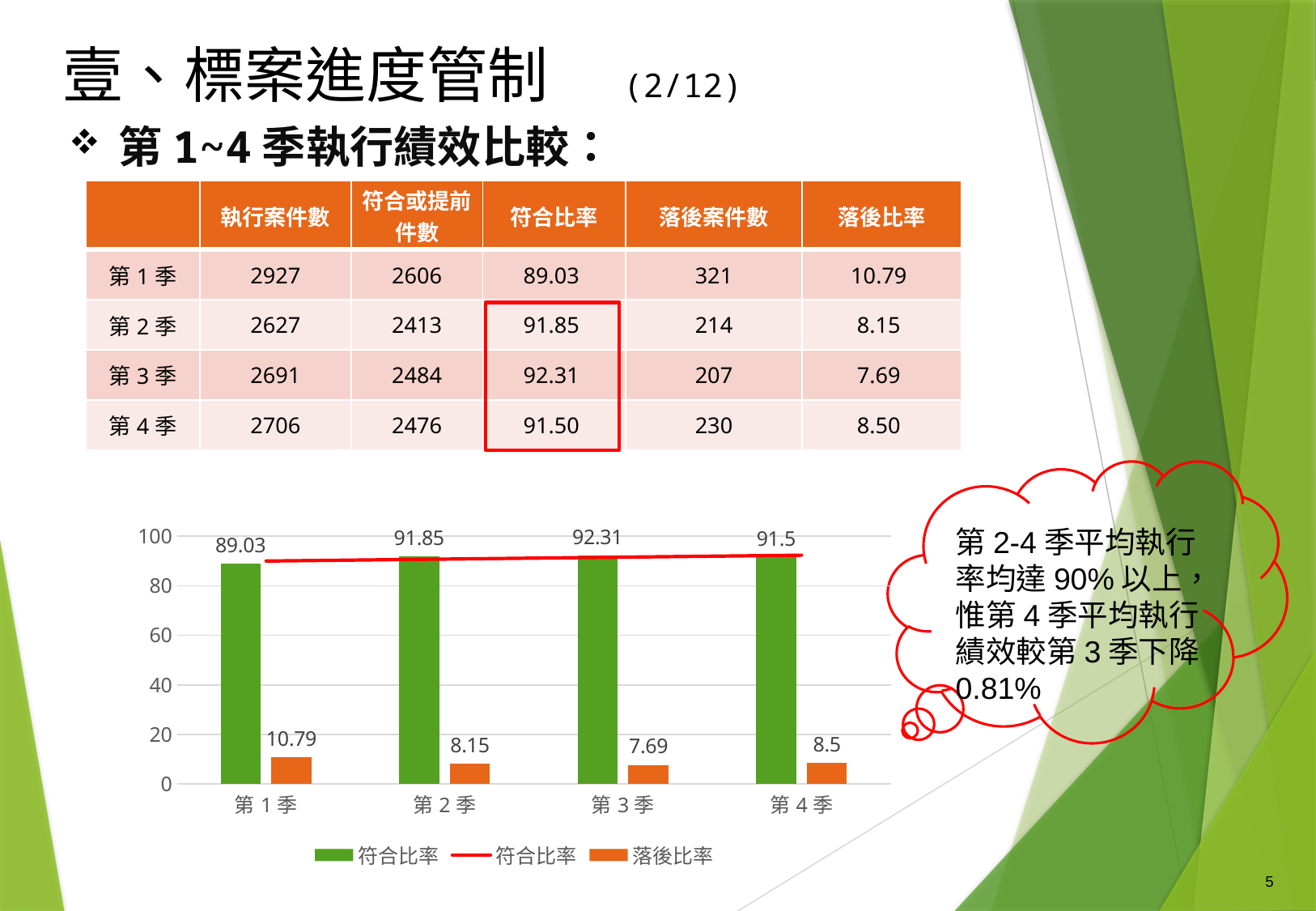
How many entries does the chart's legend list? 3 What is the 符合比率 value for 第 4 季 in the chart? 91.5 What is the difference between the 落後比率 for 第 1 季 and 第 2 季 in the chart? 2.64 Is the 符合比率 for 第 2 季 larger or smaller than the 符合比率 for 第 1 季 in the chart? larger What is the 落後比率 value for 第 3 季 in the chart? 7.69 Which quarter has the lowest 落後比率 in the chart? 第 3 季 What kind of chart is shown on the slide? bar chart Is the 落後比率 for 第 4 季 greater or less than 20 in the chart? less What is the 符合比率 value for 第 1 季 in the chart? 89.03 How many quarters are shown on the x axis of the chart? 4 Which quarter has the highest 符合比率 in the chart? 第 3 季 What colour are the 落後比率 bars in the chart? orange